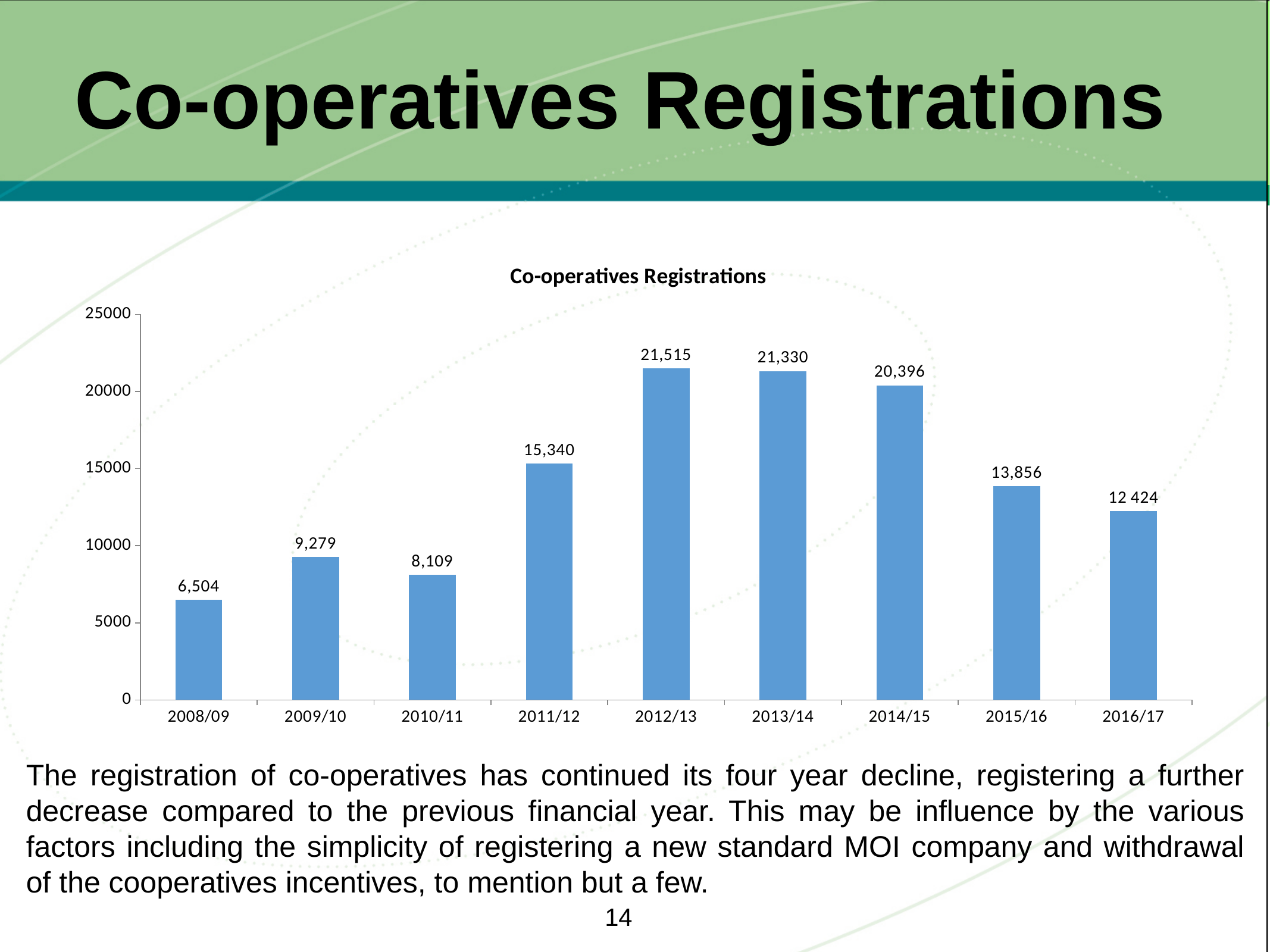
What is the difference between the values for 2012/13 and 2013/14? 185 What is the value for 2008/09 in the Co-operatives Registrations chart? 6,504 Do the values rise or fall from 2014/15 to 2016/17? fall How many years are shown on the x axis of the chart? 9 Which year has the lowest number of co-operatives registrations? 2008/09 What is the value for 2016/17 in the Co-operatives Registrations chart? 12 424 What is the value for 2012/13 in the Co-operatives Registrations chart? 21,515 Which is larger, the value for 2009/10 or the value for 2010/11? 2009/10 Which year has the highest number of co-operatives registrations? 2012/13 What is the difference between the values for 2011/12 and 2010/11? 7,231 What kind of chart is shown on the slide? bar chart Is the value for 2015/16 greater or less than 15000? less